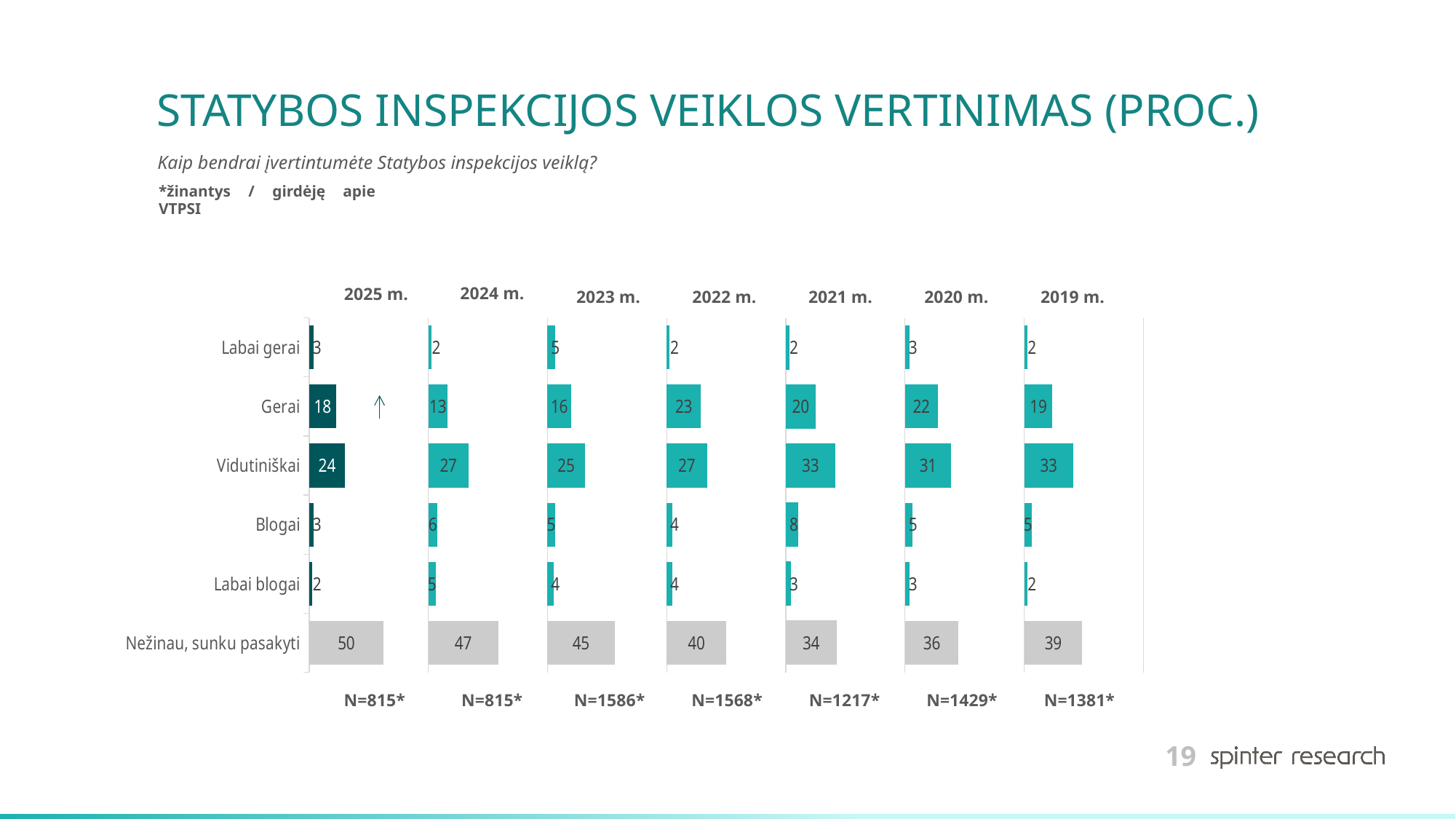
How many years are shown in the chart? 7 Which year has the lowest value for "Gerai"? 2024 m. What is the value for "Vidutiniškai" in 2021 m.? 33 Which is larger: the "Gerai" value in 2022 m. or in 2020 m.? 2022 m. How many response categories are listed on the vertical axis? 6 Which year has the highest value for "Nežinau, sunku pasakyti"? 2025 m. What is the value for "Nežinau, sunku pasakyti" in 2022 m.? 40 What is the value for "Gerai" in 2025 m.? 18 What is the difference between the "Vidutiniškai" values in 2024 m. and 2025 m.? 3 Which year's bars are drawn in a darker colour than the others? 2025 m. What kind of chart is shown on the slide? Bar chart What is the value for "Blogai" in 2024 m.? 6